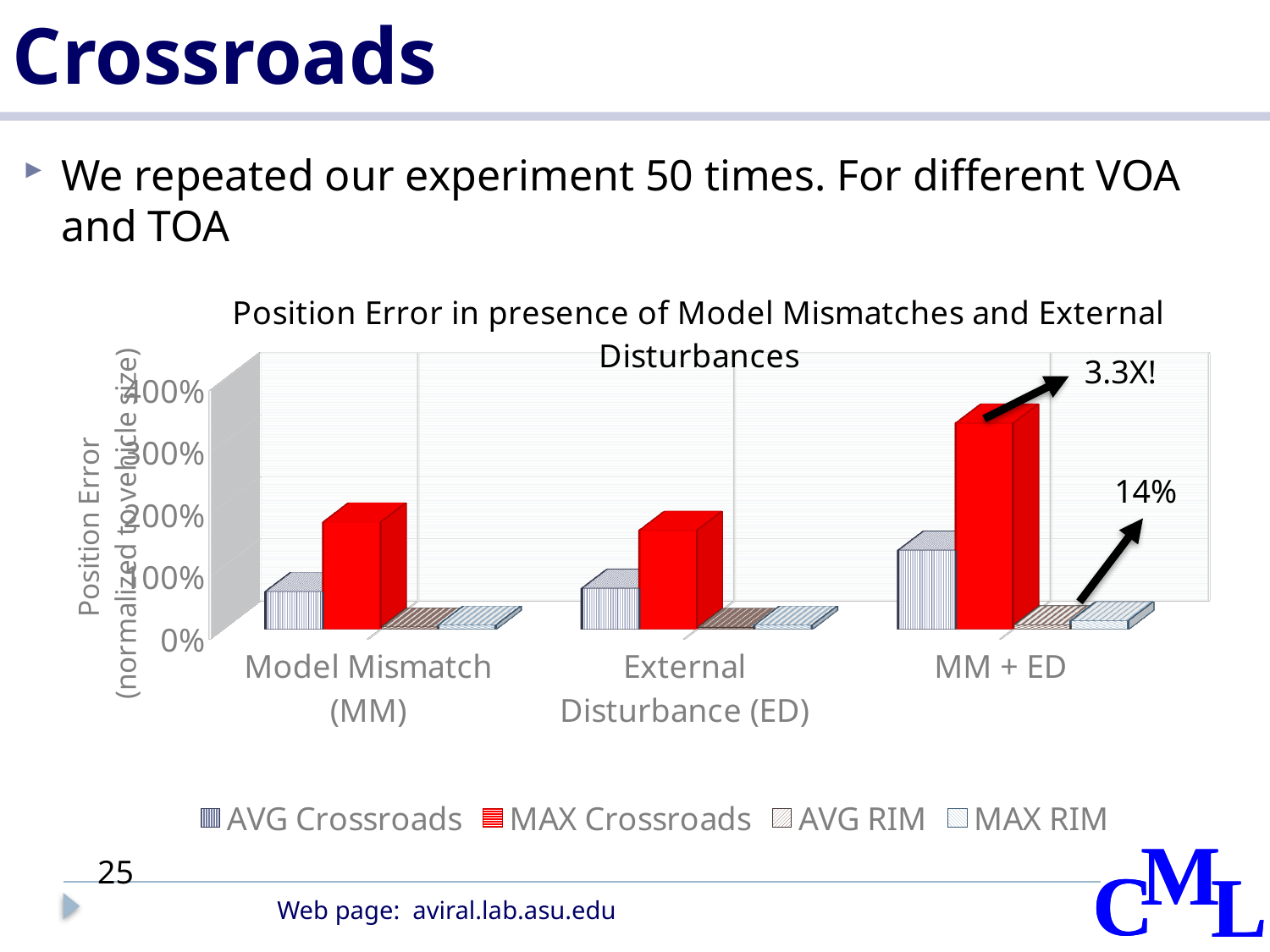
Which category has the highest MAX Crossroads value? MM + ED Is the MAX Crossroads value for Model Mismatch (MM) greater or less than 100%? greater For Model Mismatch (MM), which is larger: the AVG Crossroads value or the MAX RIM value? AVG Crossroads Is the AVG Crossroads value for Model Mismatch (MM) greater or less than 100%? less How many series does the chart legend list? 4 For MM + ED, which is larger: the MAX Crossroads value or the AVG RIM value? MAX Crossroads Is the MAX Crossroads value for MM + ED greater or less than 300%? greater What annotation text is attached to the MAX Crossroads bar for MM + ED? 3.3X! How many categories are shown on the x axis of the chart? 3 What kind of chart is shown on the slide? bar chart What is the title of the chart? Position Error in presence of Model Mismatches and External Disturbances